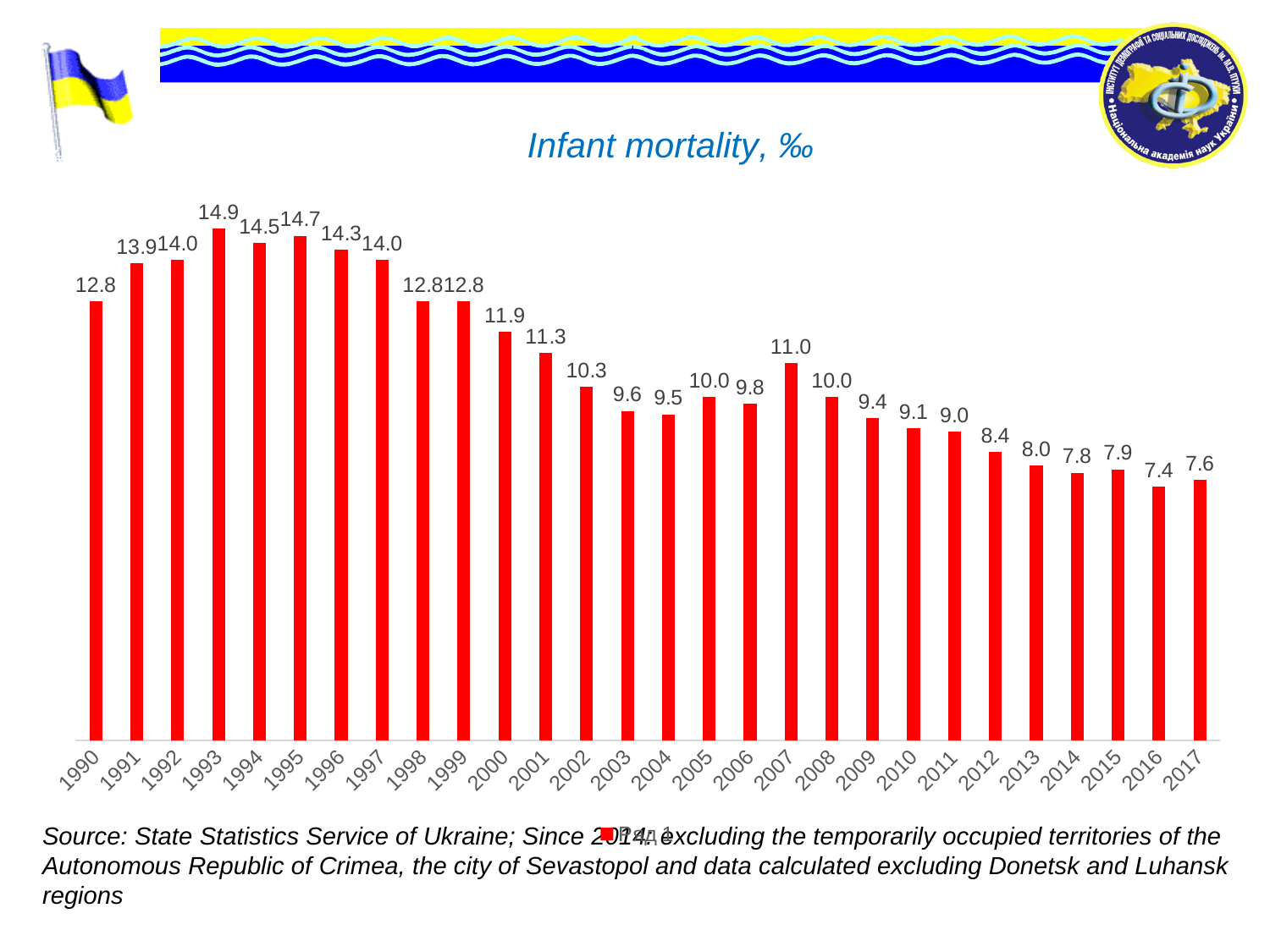
Which year has the highest infant mortality value? 1993 What is the difference between the infant mortality values for 1993 and 2016? 7.5 How many years are shown on the x axis of the chart? 28 What kind of chart is shown on the slide? Bar chart Which year has the lowest infant mortality value? 2016 Which year has a higher infant mortality value, 2007 or 2012? 2007 What is the infant mortality value for 2017? 7.6 What is the infant mortality value for 2002? 10.3 What is the difference between the infant mortality values for 1990 and 2017? 5.2 What is the infant mortality value for 1993? 14.9 What is the infant mortality value for 2007? 11.0 What is the title of the chart? Infant mortality, ‰